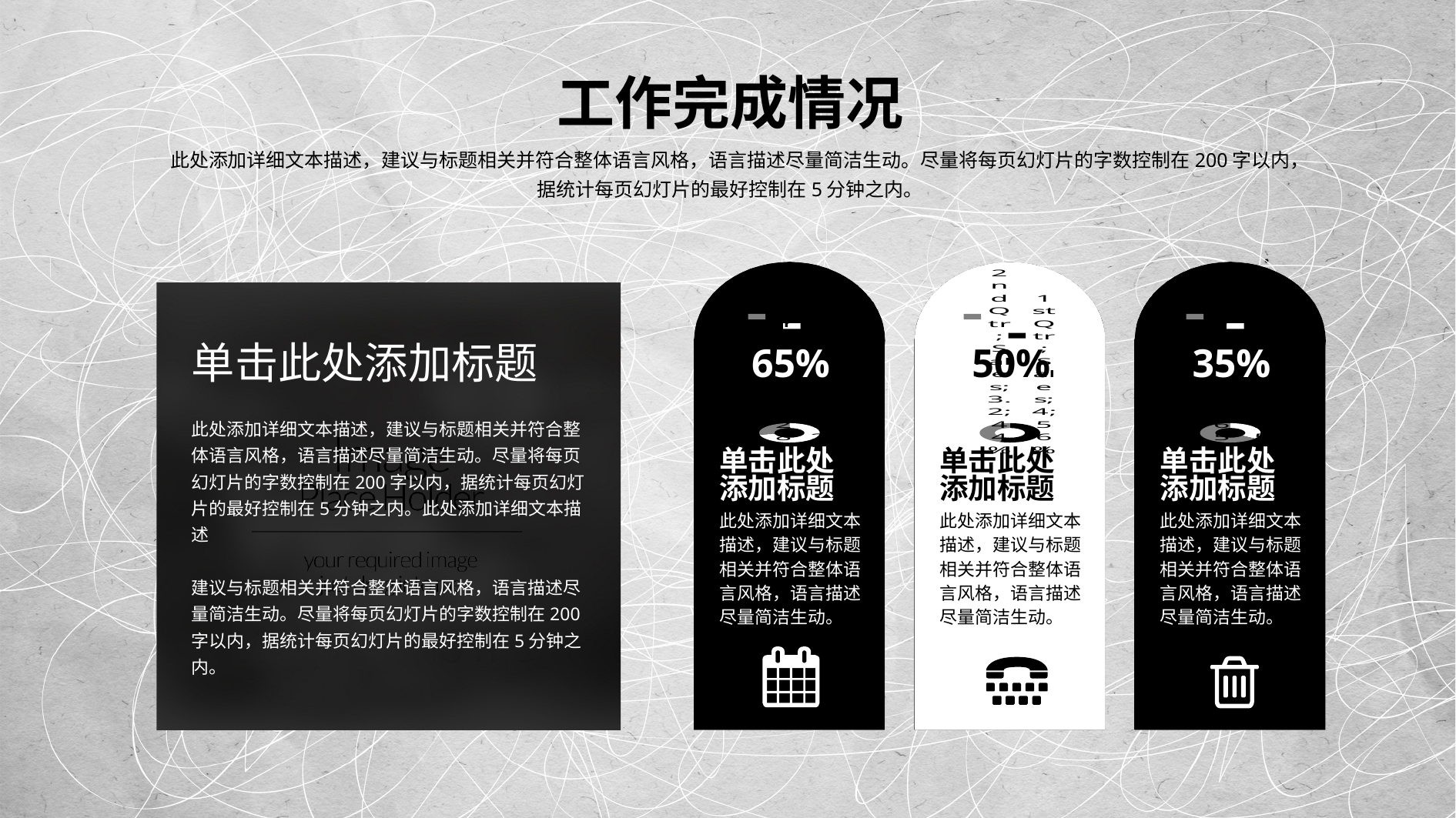
What is the difference between the percentage on the left panel and the percentage on the right panel? 30% What is the title of the slide containing the charts? 工作完成情况 Do the percentages rise or fall moving from the left panel to the right panel? Fall Which is larger, the percentage on the middle panel or the percentage on the right panel? The middle panel (50%) Which of the three panels shows the lowest percentage? The right panel (35%) What percentage is shown on the middle white panel chart? 50% What percentage is shown on the left black panel chart? 65% Which of the three panels shows the highest percentage? The left panel (65%) What is the difference between the percentage on the left panel and the percentage on the middle panel? 15% What percentage is shown on the right black panel chart? 35% How many small charts with percentages are shown on the slide? 3